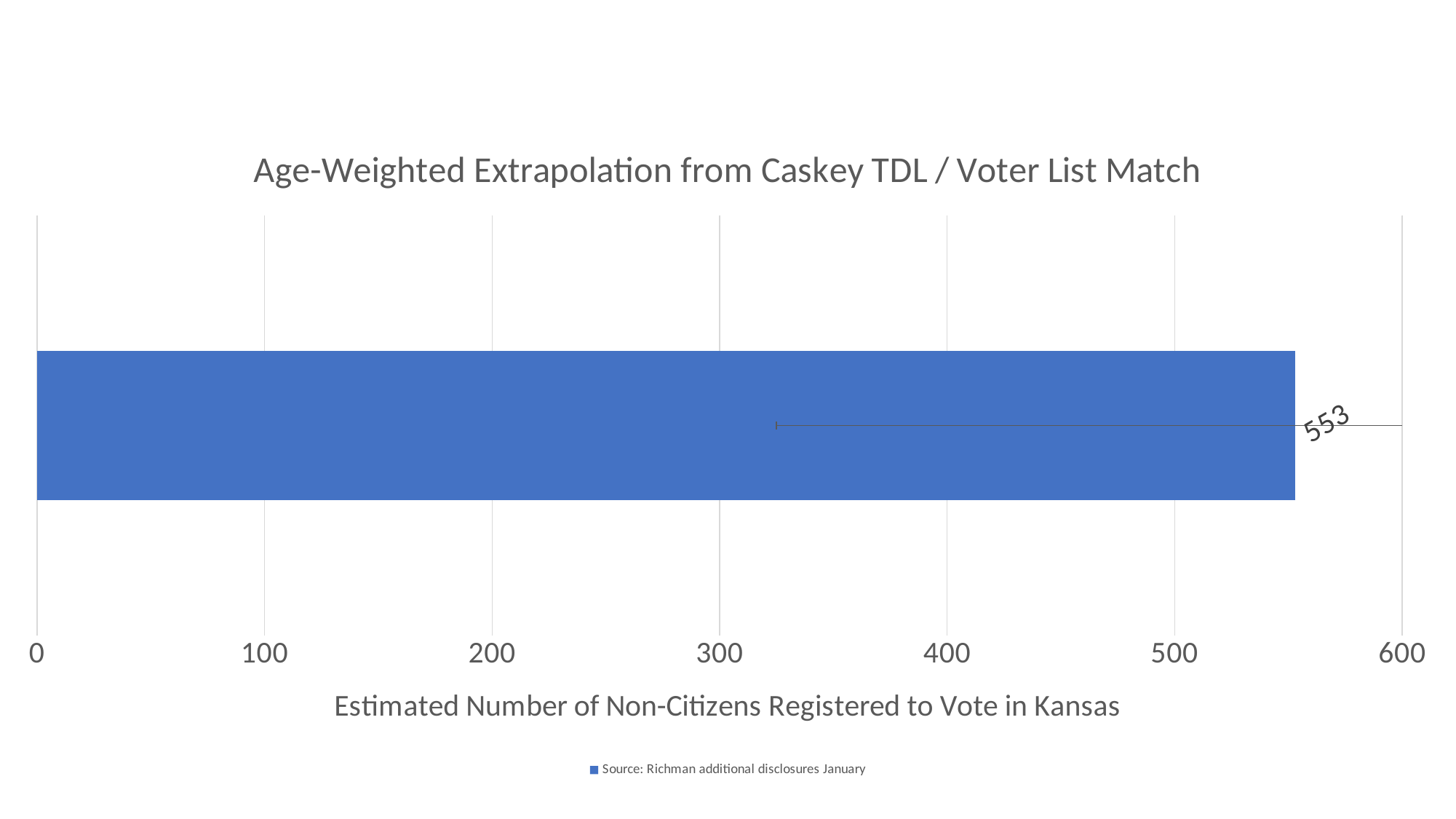
What is the label on the horizontal axis? Estimated Number of Non-Citizens Registered to Vote in Kansas What kind of chart is shown on the slide? bar chart What is the title of the chart? Age-Weighted Extrapolation from Caskey TDL / Voter List Match How many series does the legend list? 1 How many bars are plotted in the chart? 1 Is the value of the bar greater or less than 600? less What is the highest value shown on the horizontal axis? 600 What is the value shown by the data label on the bar? 553 Is the value of the bar greater or less than 500? greater